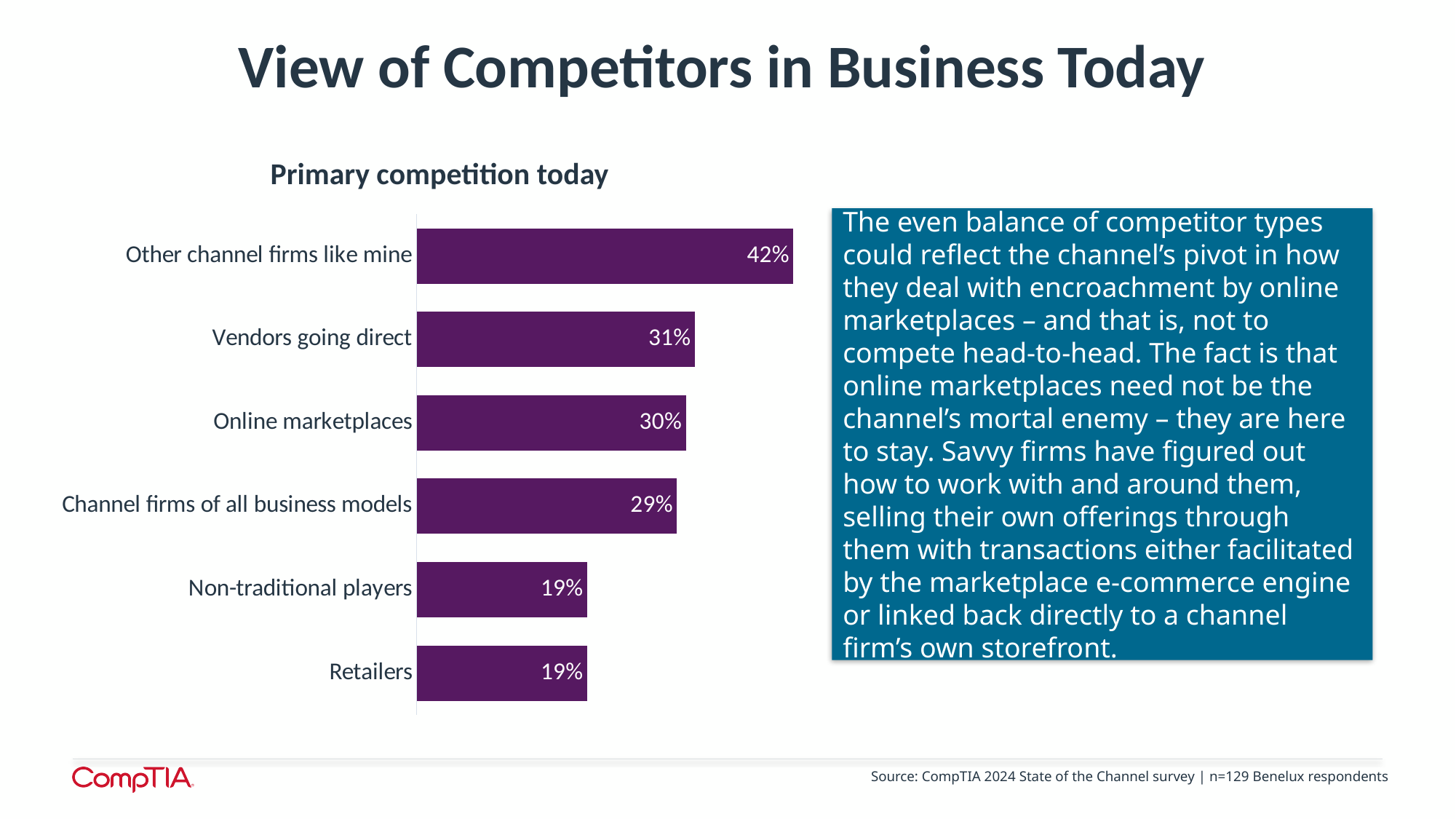
What kind of chart is shown on the slide? Bar chart How many categories are shown in the chart? 6 What is the value for channel firms of all business models? 29% What is the difference between the values for other channel firms like mine and vendors going direct? 11% What is the difference between the values for online marketplaces and retailers? 11% Which is larger, the value for vendors going direct or the value for channel firms of all business models? Vendors going direct What is the title of the chart? Primary competition today What is the value for online marketplaces? 30% What percentage of respondents cite other channel firms like mine as their primary competition today? 42% What is the value for vendors going direct? 31% Which category has the highest value in the chart? Other channel firms like mine What is the value for non-traditional players? 19%